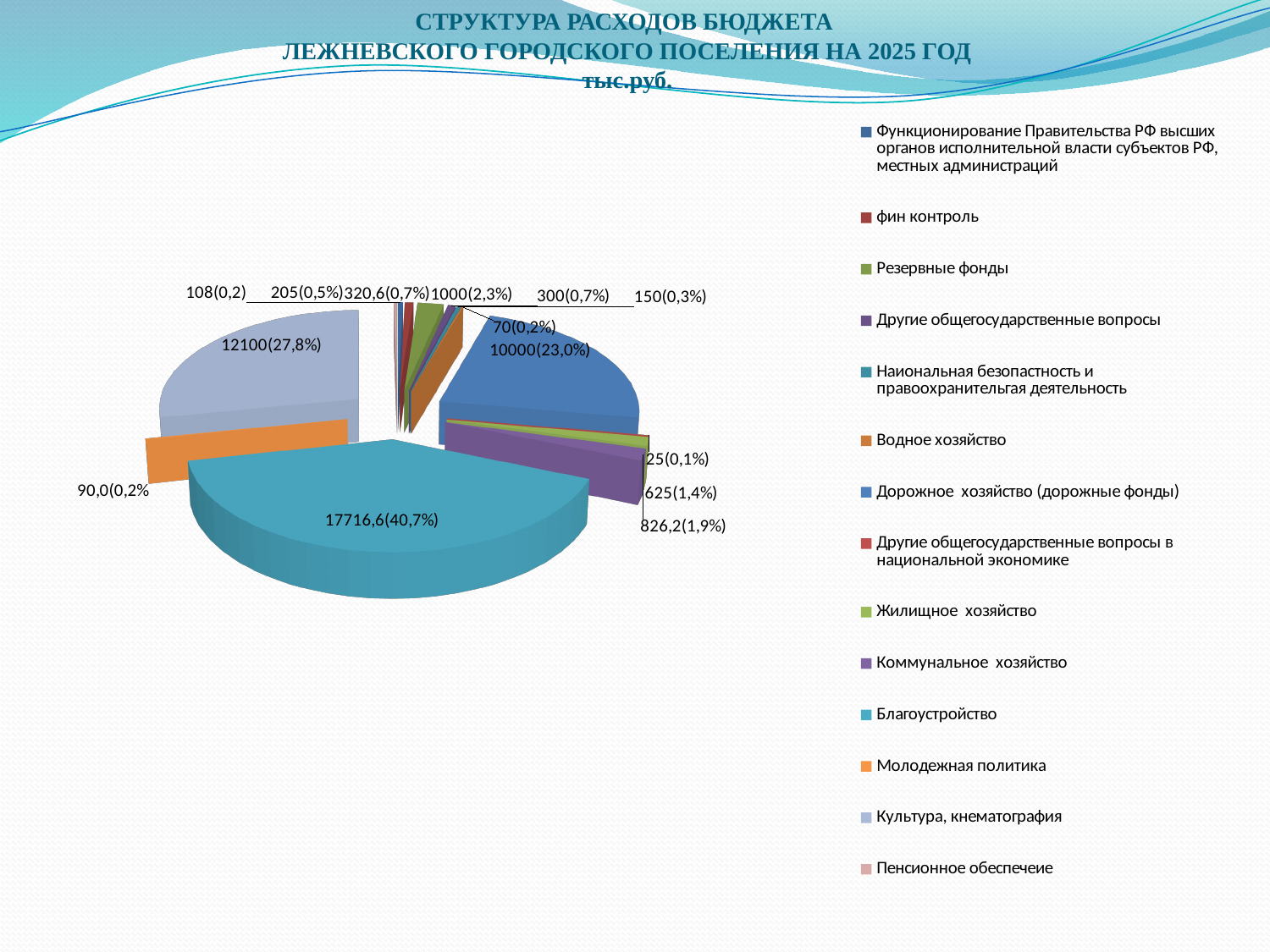
What value is shown for Дорожное хозяйство (дорожные фонды)? 10000 What is the smallest share shown on the pie chart? 0,1% What is the difference between the Благоустройство value (17716,6) and the Культура, кнематография value (12100)? 5616,6 What kind of chart is shown on the slide? pie chart Which is larger: Благоустройство or Культура, кнематография? Благоустройство What share of the pie does the largest slice (Благоустройство) have? 40,7% How many entries does the legend list? 14 What value is shown for the largest slice of the pie? 17716,6 What is the difference between the Культура, кнематография value (12100) and the Дорожное хозяйство value (10000)? 2100 In what units are the values on the chart given, according to the title? тыс.руб. What value is shown for Культура, кнематография? 12100 What share of the pie does Культура, кнематография have? 27,8%